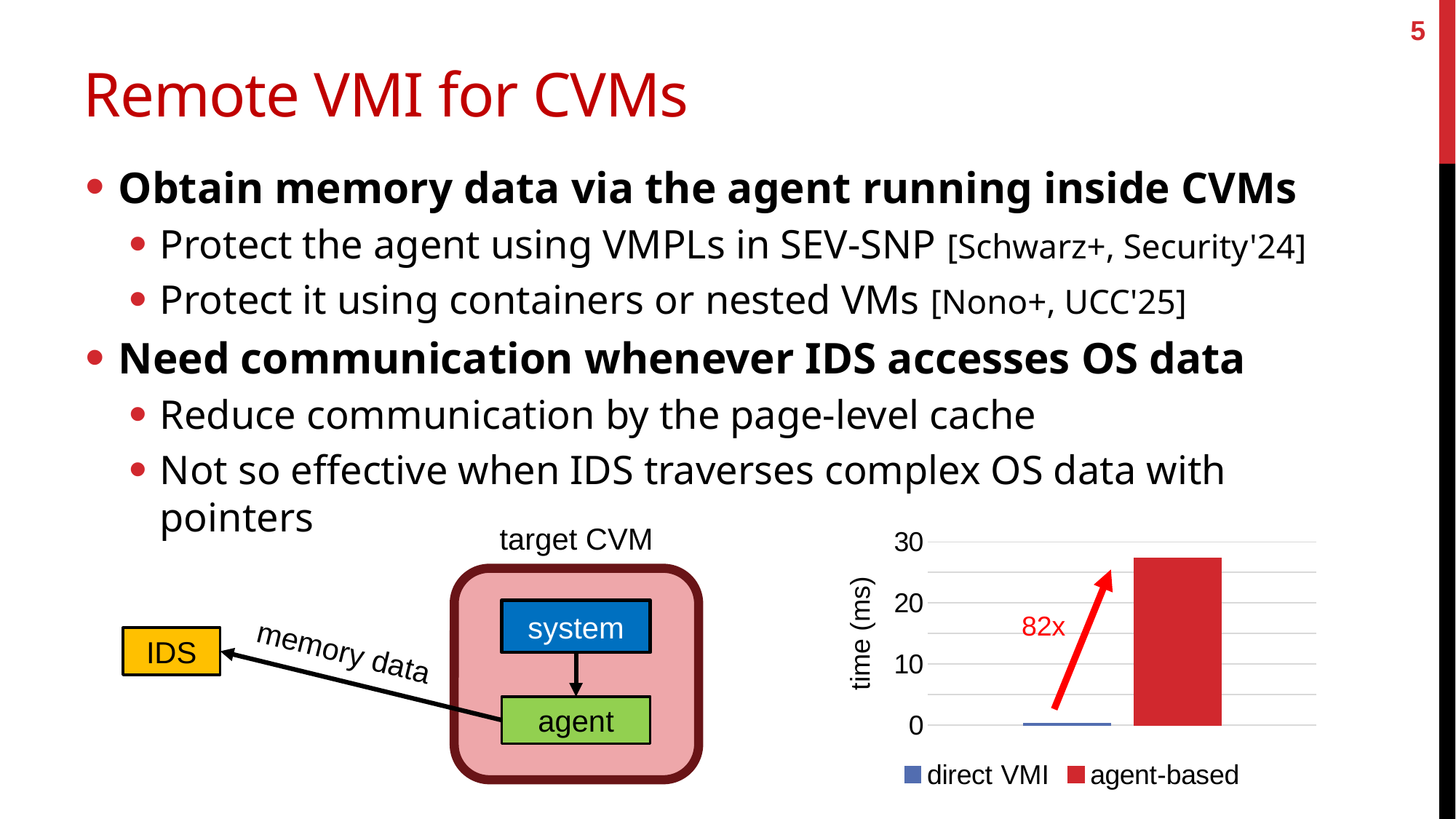
Is the value for agent-based greater or less than 30? less Is the time for agent-based larger or smaller than the time for direct VMI? larger Which series has the lower time in the chart? direct VMI What kind of chart is shown on the slide? bar chart What factor is written next to the red arrow in the chart? 82x How many series does the chart's legend list? 2 What is the label of the chart's vertical axis? time (ms) What is the highest tick value shown on the chart's vertical axis? 30 Is the value for agent-based greater or less than 20? greater Which series has the higher time in the chart? agent-based Is the value for direct VMI greater or less than 10? less